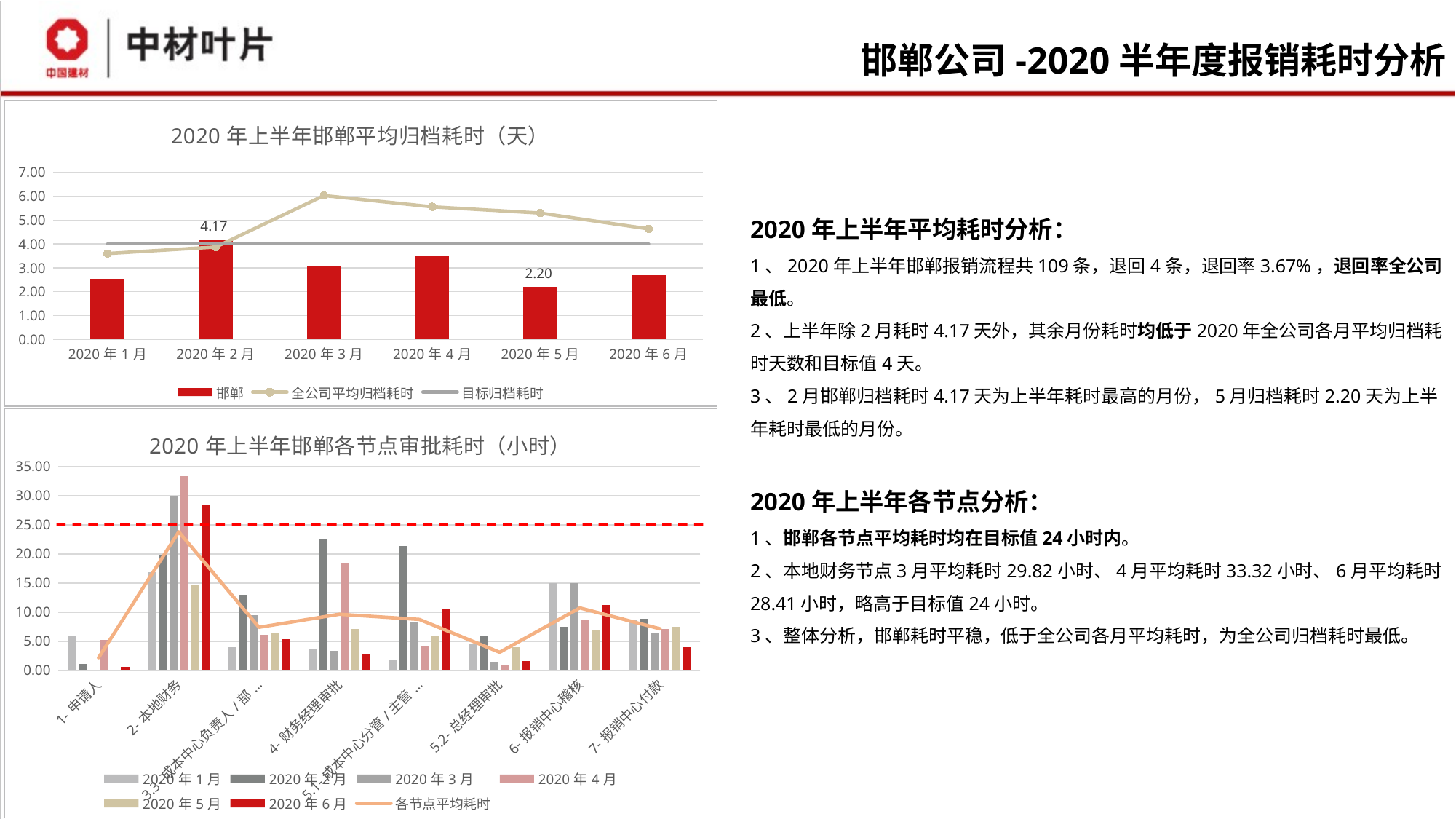
In the top chart '2020年上半年邯郸平均归档耗时（天）', which month has the highest 邯郸 value? 2020年2月 In the top chart '2020年上半年邯郸平均归档耗时（天）', how many months are shown on the x axis? 6 In the top chart '2020年上半年邯郸平均归档耗时（天）', how many series does the legend list? 3 In the bottom chart '2020年上半年邯郸各节点审批耗时（小时）', is the 2020年4月 value for 2-本地财务 greater or less than 30.00? greater In the top chart '2020年上半年邯郸平均归档耗时（天）', which month has the lowest 邯郸 value? 2020年5月 In the top chart '2020年上半年邯郸平均归档耗时（天）', does the 全公司平均归档耗时 line rise or fall from 2020年3月 to 2020年6月? fall In the top chart '2020年上半年邯郸平均归档耗时（天）', what is the value for 邯郸 in 2020年5月? 2.20 In the top chart '2020年上半年邯郸平均归档耗时（天）', is the 全公司平均归档耗时 value for 2020年3月 greater or less than 5.00? greater In the top chart '2020年上半年邯郸平均归档耗时（天）', what is the value for 邯郸 in 2020年2月? 4.17 In the bottom chart '2020年上半年邯郸各节点审批耗时（小时）', how many nodes (categories) are shown on the x axis? 8 In the bottom chart '2020年上半年邯郸各节点审批耗时（小时）', how many series does the legend list? 7 In the top chart '2020年上半年邯郸平均归档耗时（天）', what is the difference between the 邯郸 values for 2020年2月 and 2020年5月? 1.97